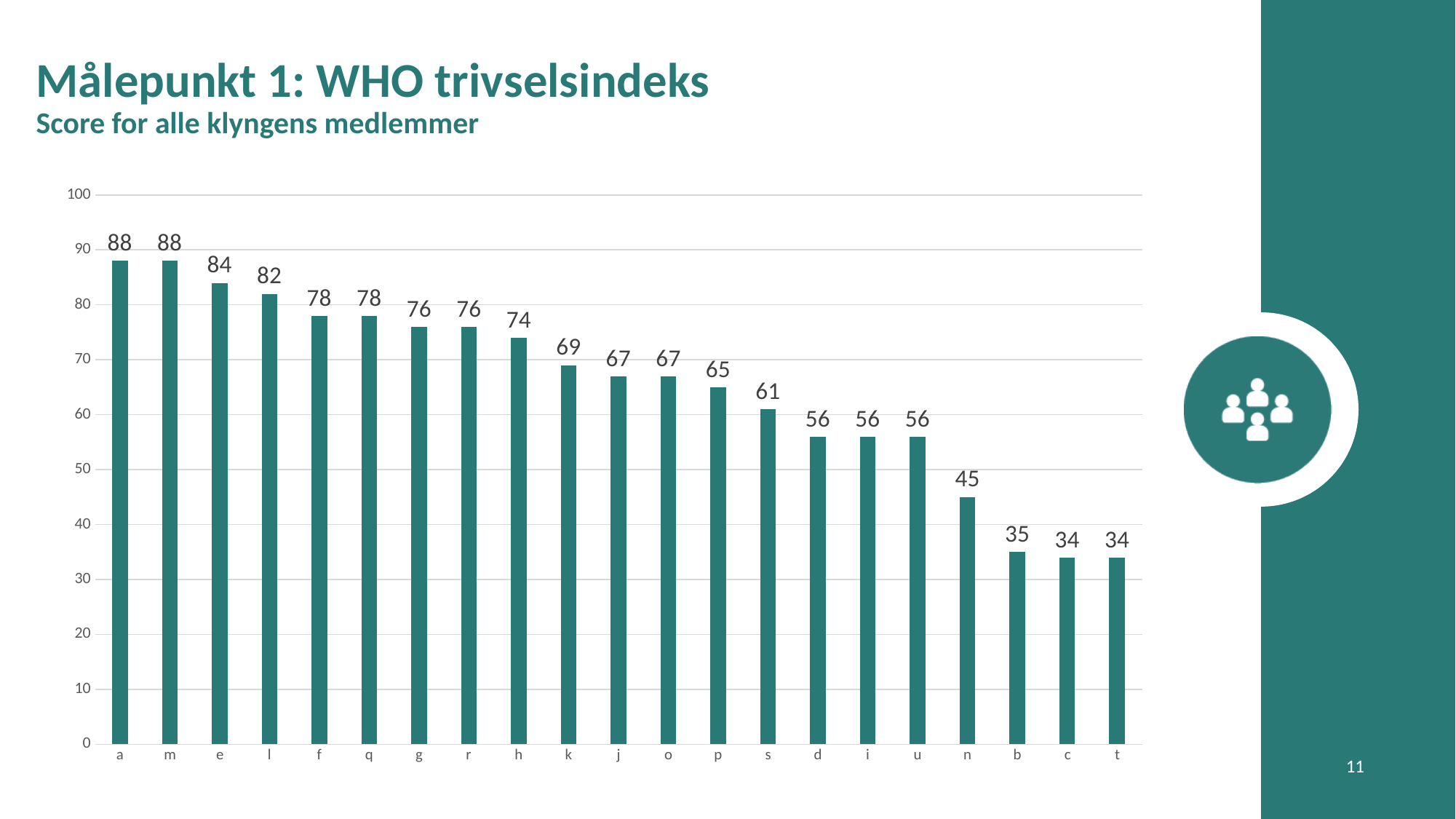
How many categories are shown on the x axis? 21 Do the values rise or fall from left to right along the x axis? fall What is the highest value shown in the chart? 88 What is the value for category k? 69 What is the value for category e? 84 What kind of chart is shown on the slide? bar chart Which has a larger value, h or d? h What is the difference between the values for l and p? 17 What is the lowest value shown in the chart? 34 What is the difference between the values for a and t? 54 What is the value for category n? 45 What is the value for category s? 61